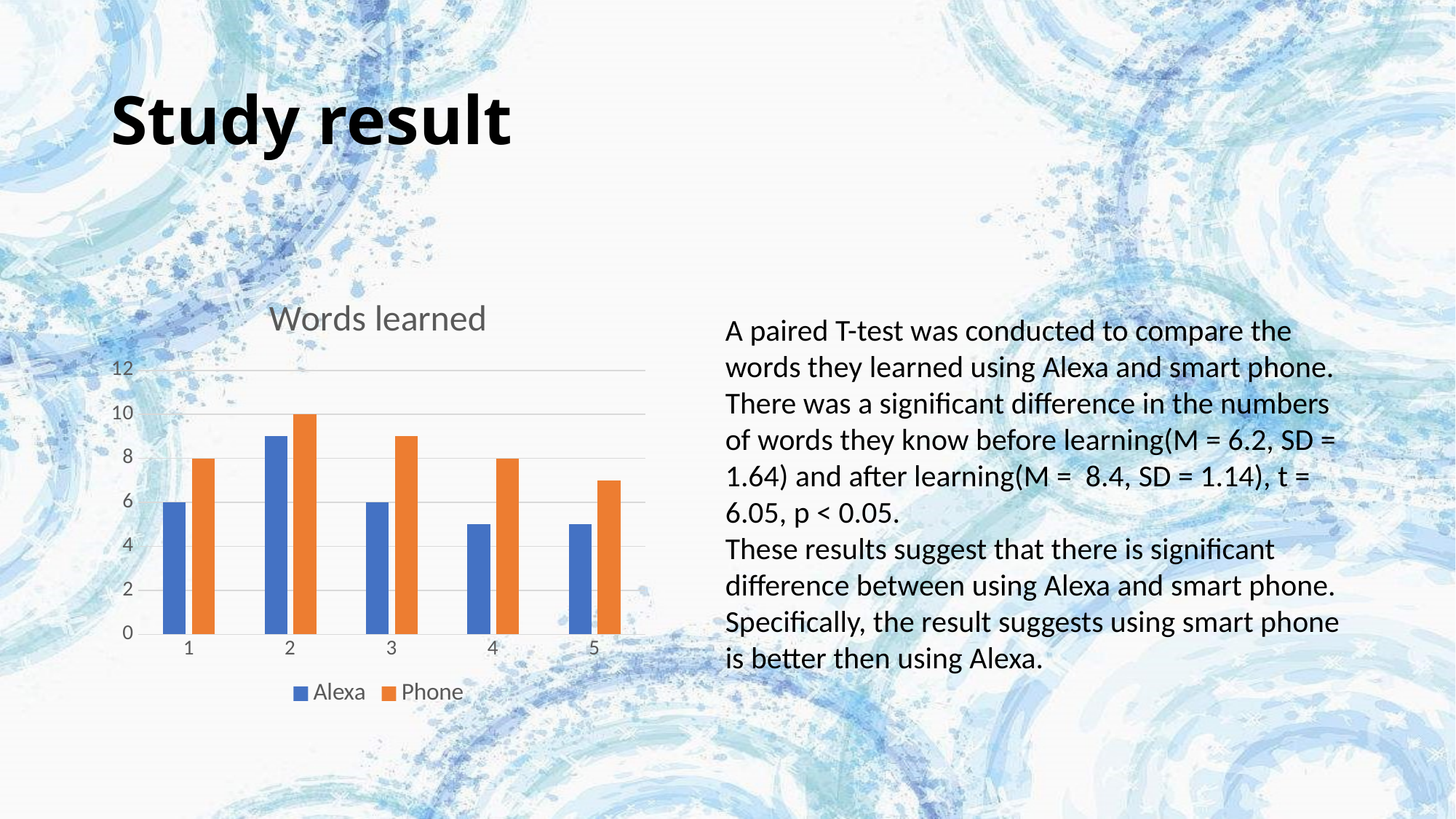
What is the Alexa value for category 1? 6 What is the Phone value for category 2? 10 For category 3, which series has the larger value, Alexa or Phone? Phone What is the difference between the Phone values for category 2 and category 1? 2 How many categories are shown on the x axis of the chart? 5 For which category is the Phone value lowest? 5 How many series does the legend of the chart list? 2 Is the Alexa value for category 2 greater or less than 8? greater For which category is the Phone value highest? 2 For which category is the Alexa value highest? 2 What is the title of the chart? Words learned What kind of chart is shown on the slide? bar chart